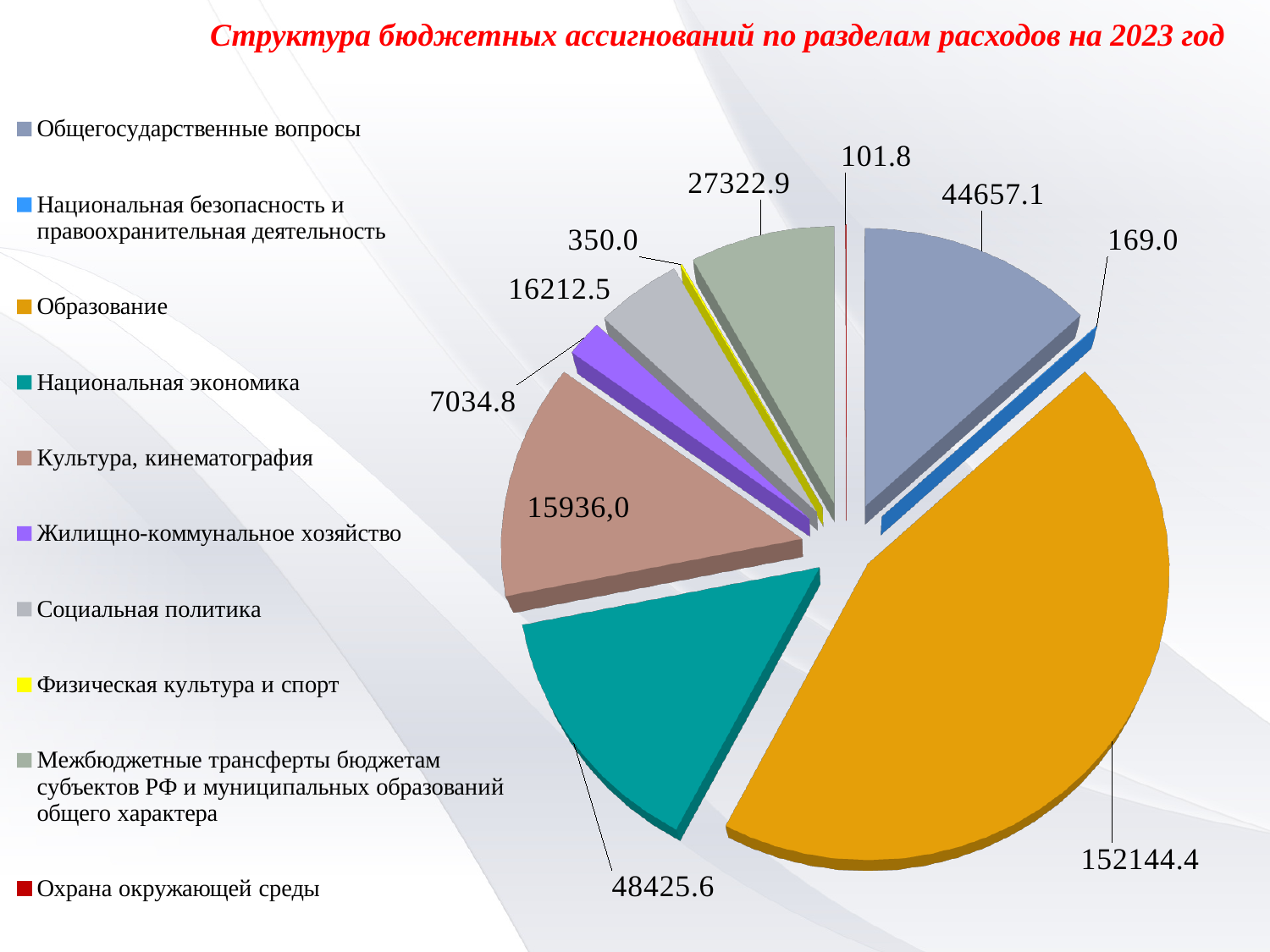
What is the value for Национальная экономика? 48425.6 What kind of chart is shown on the slide? Pie chart What is the difference between the values for Национальная экономика and Общегосударственные вопросы? 3768.5 What is the value for Межбюджетные трансферты бюджетам субъектов РФ и муниципальных образований общего характера? 27322.9 Which category has the largest slice of the pie? Образование How many categories does the legend list? 10 What is the value for Охрана окружающей среды? 101.8 Which category has the smallest value? Охрана окружающей среды What is the value for Общегосударственные вопросы? 44657.1 What is the title of the chart? Структура бюджетных ассигнований по разделам расходов на 2023 год What is the value for Образование? 152144.4